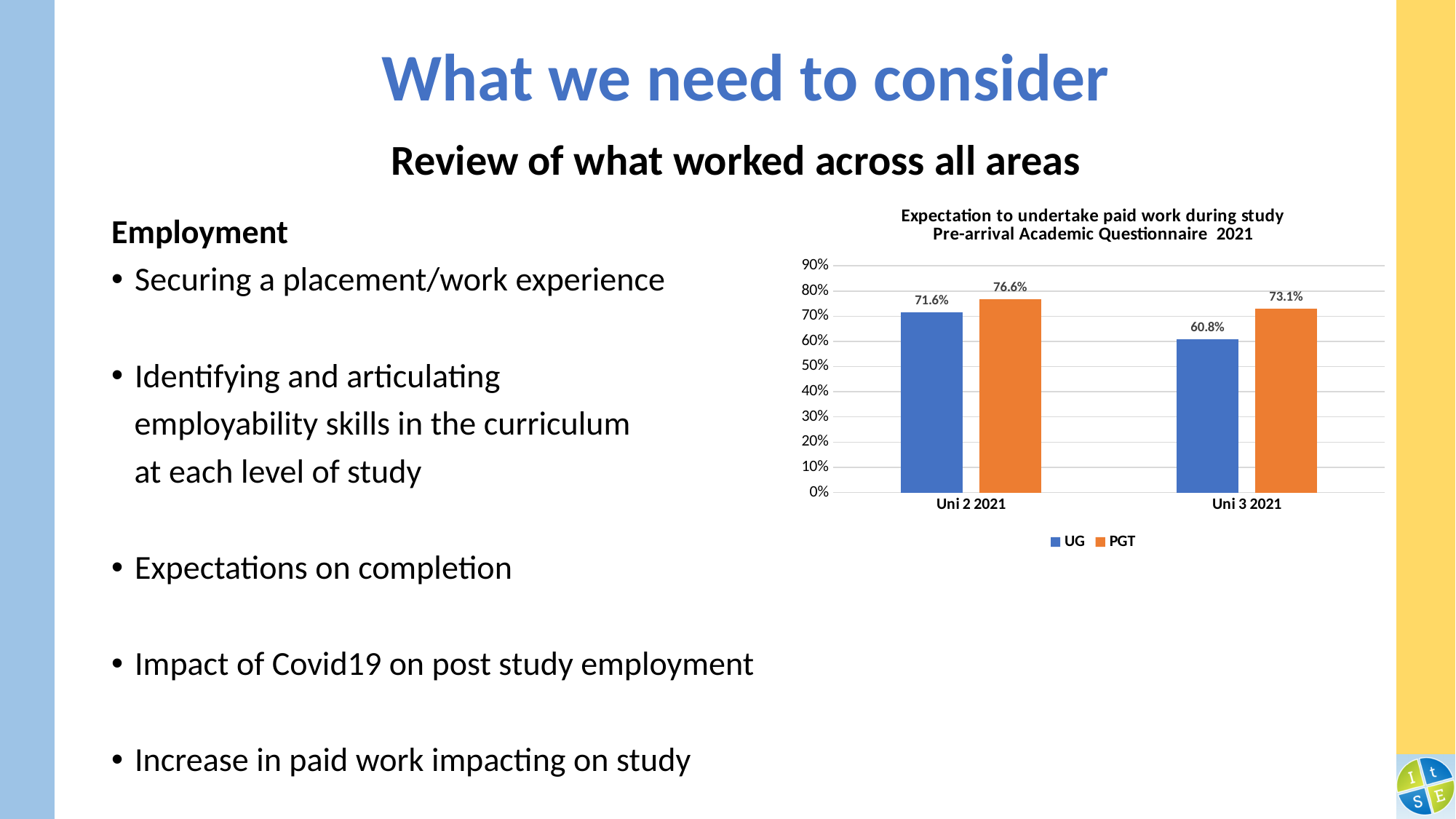
What is the UG value for Uni 2 2021? 71.6% What is the PGT value for Uni 3 2021? 73.1% What kind of chart is shown on the slide? Bar chart Which bar has the highest value in the chart? PGT for Uni 2 2021 What colour are the PGT bars in the chart? Orange What is the difference between the UG values for Uni 2 2021 and Uni 3 2021? 10.8% What is the PGT value for Uni 2 2021? 76.6% What is the difference between the PGT and UG values for Uni 3 2021? 12.3% How many series does the legend list? 2 What is the UG value for Uni 3 2021? 60.8% Which bar has the lowest value in the chart? UG for Uni 3 2021 Which is larger, the UG value for Uni 2 2021 or the UG value for Uni 3 2021? Uni 2 2021